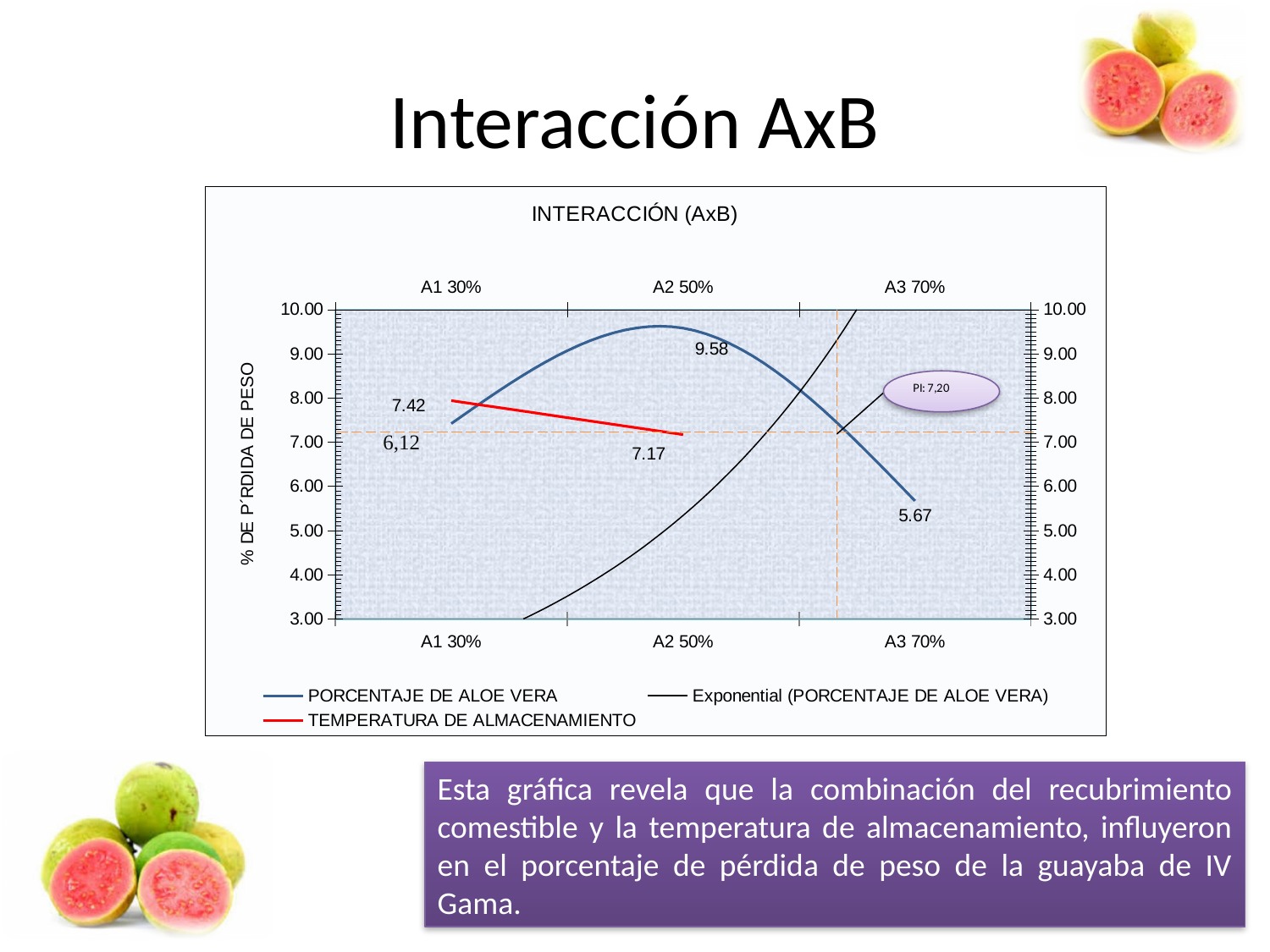
What is the value of PORCENTAJE DE ALOE VERA at A1 30%? 7.42 How many categories are shown on the x axis? 3 Is the PORCENTAJE DE ALOE VERA value at A3 70% greater or less than 6.00? less At which category does PORCENTAJE DE ALOE VERA reach its highest value? A2 50% What is the title of the chart? INTERACCIÓN (AxB) How many series does the legend list? 3 What is the difference between the PORCENTAJE DE ALOE VERA values at A2 50% and A3 70%? 3.91 What is the value of PORCENTAJE DE ALOE VERA at A2 50%? 9.58 Which is larger for PORCENTAJE DE ALOE VERA: the value at A1 30% or at A3 70%? A1 30% What type of chart is shown on the slide? Line chart What is the value of PORCENTAJE DE ALOE VERA at A3 70%? 5.67 At which category does PORCENTAJE DE ALOE VERA reach its lowest value? A3 70%